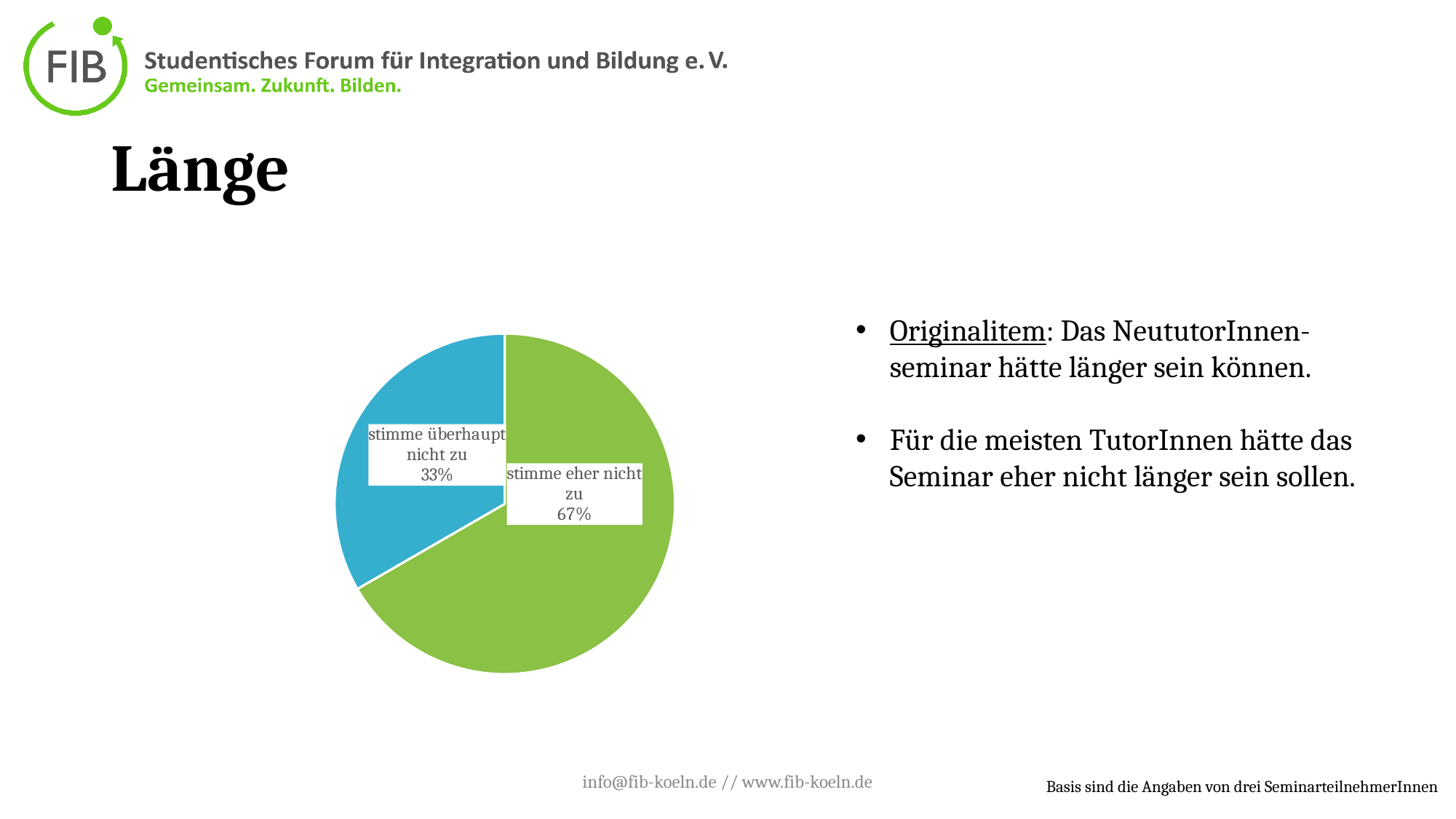
What colour is the "stimme überhaupt nicht zu" slice? blue What kind of chart is shown on the slide? pie chart How many slices does the pie chart have? 2 What share of the pie does "stimme eher nicht zu" have? 67% Which slice of the pie is the largest? stimme eher nicht zu What colour is the "stimme eher nicht zu" slice? green What is the difference in percentage points between "stimme eher nicht zu" and "stimme überhaupt nicht zu"? 34 What share of the pie does "stimme überhaupt nicht zu" have? 33% Which slice of the pie is the smallest? stimme überhaupt nicht zu Which is larger, the share for "stimme eher nicht zu" or for "stimme überhaupt nicht zu"? stimme eher nicht zu